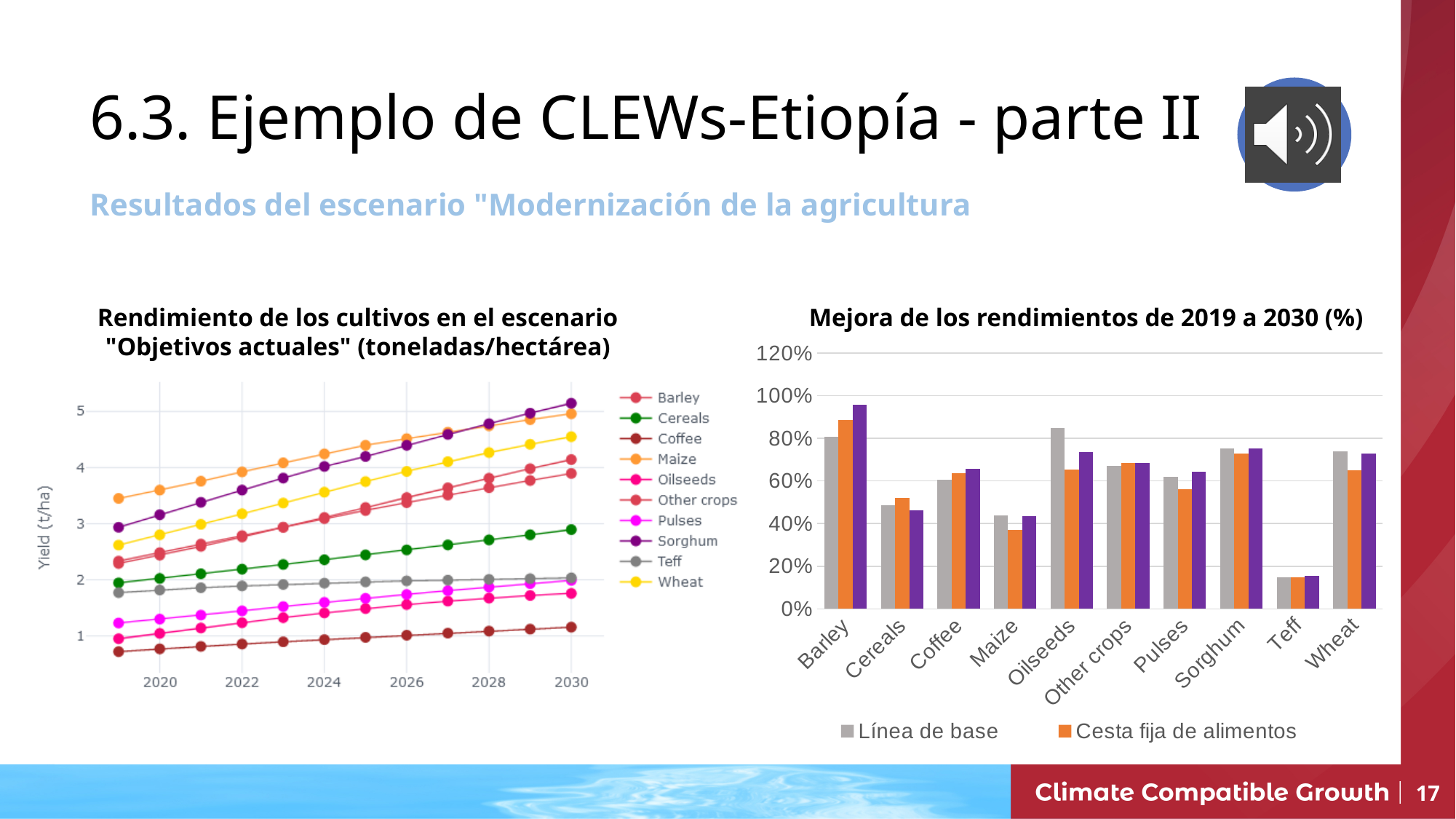
In the chart "Mejora de los rendimientos de 2019 a 2030 (%)", how many crop categories are shown on the x axis? 10 In the chart "Mejora de los rendimientos de 2019 a 2030 (%)", is the Teff value for Línea de base greater or less than 20%? less In the chart "Mejora de los rendimientos de 2019 a 2030 (%)", which is larger for Línea de base: Oilseeds or Pulses? Oilseeds What kind of chart is the chart titled "Mejora de los rendimientos de 2019 a 2030 (%)"? bar chart In the chart "Mejora de los rendimientos de 2019 a 2030 (%)", which crop has the lowest improvement values? Teff In the left line chart, how many series does the legend list? 10 In the left line chart, is the Sorghum yield in 2030 greater or less than 5 t/ha? greater In the left line chart, do the yield values rise or fall from 2020 to 2030? rise In the chart "Mejora de los rendimientos de 2019 a 2030 (%)", is the Maize value for Cesta fija de alimentos greater or less than 40%? less What kind of chart is the chart on the left titled "Rendimiento de los cultivos en el escenario 'Objetivos actuales'"? line chart In the left line chart, which crop has the lowest yield across all years? Coffee